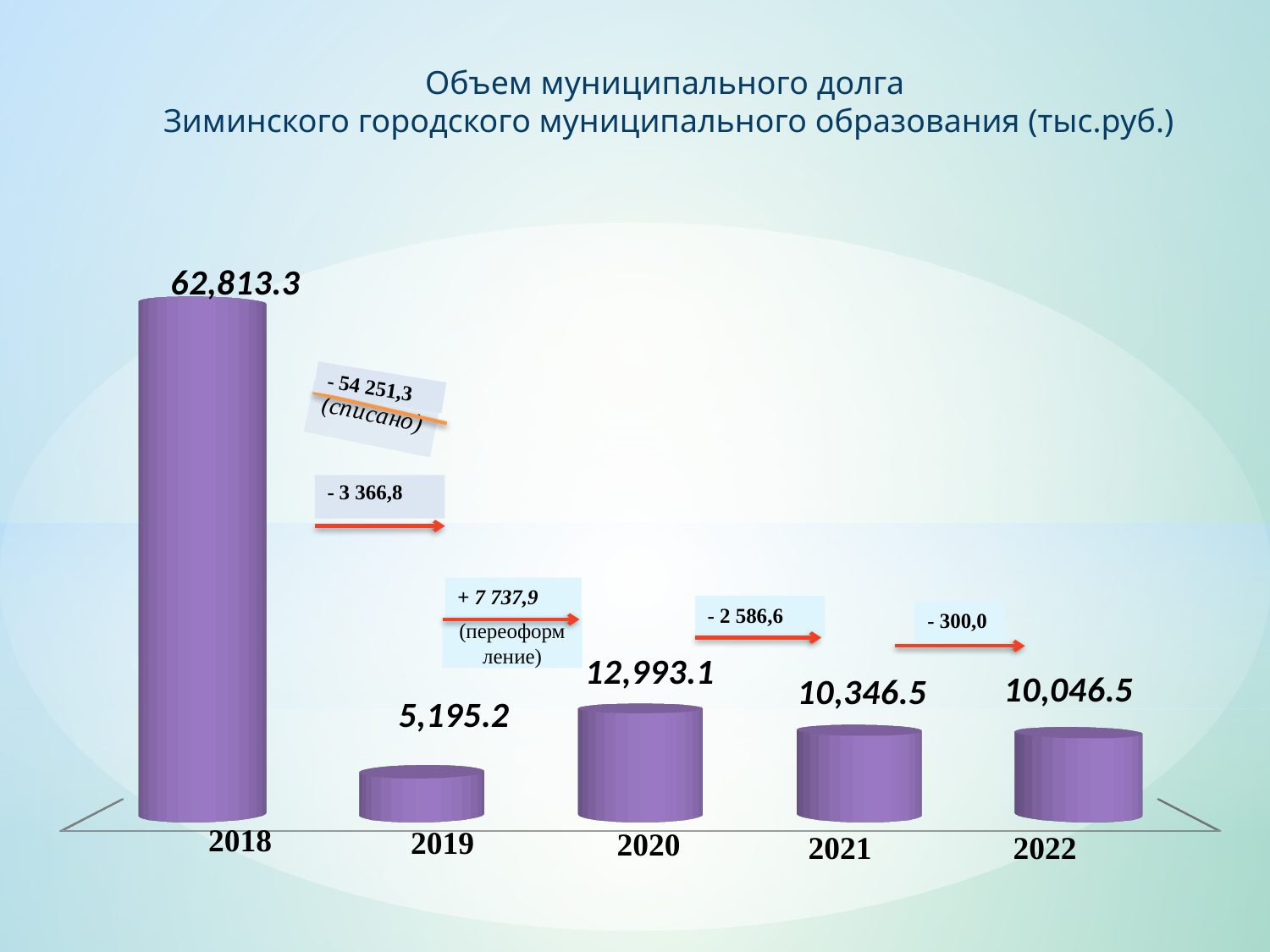
In what units are the values on the chart expressed, according to the title? тыс.руб. Which year has the highest volume of municipal debt? 2018 How many years are shown on the chart? 5 What kind of chart is shown on the slide? Bar chart What is the volume of municipal debt for 2022? 10,046.5 What is the difference between the municipal debt in 2020 and in 2019? 7,797.9 What is the volume of municipal debt for 2018? 62,813.3 What is the volume of municipal debt for 2020? 12,993.1 What is the volume of municipal debt for 2019? 5,195.2 Which year has a larger municipal debt, 2020 or 2021? 2020 Which year has the lowest volume of municipal debt? 2019 What is the difference between the municipal debt in 2021 and in 2022? 300.0